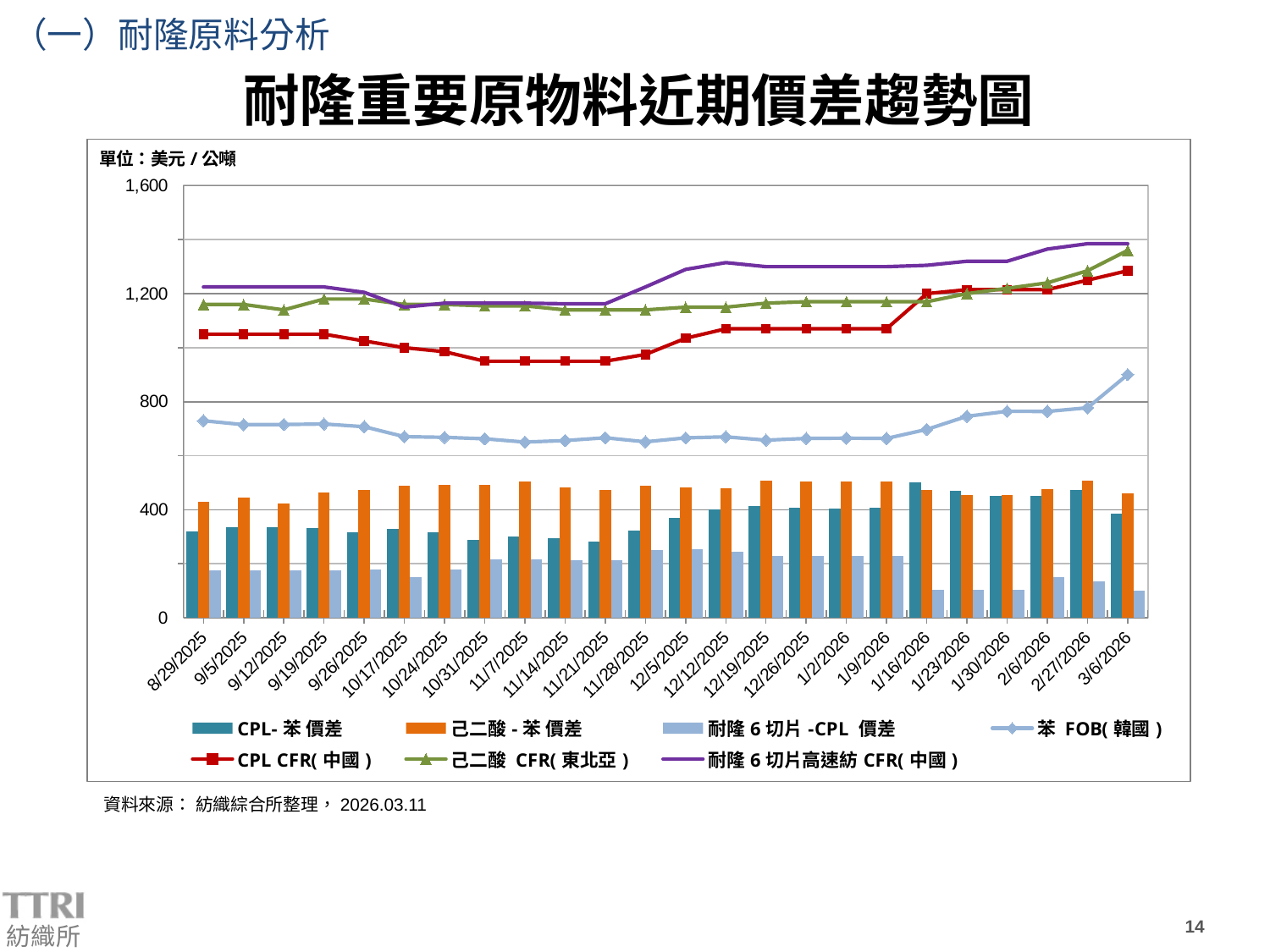
What is the title of the chart? 耐隆重要原物料近期價差趨勢圖 Is the value for CPL CFR(中國) on 10/31/2025 greater or less than 1,200? less How many series does the legend list? 7 How many dates are shown along the x axis? 24 What kind of chart is shown on the slide? A combined bar and line chart On 3/6/2026, which is larger: CPL-苯 價差 or 己二酸-苯 價差? 己二酸-苯 價差 Does 苯 FOB(韓國) rise or fall from 1/9/2026 to 3/6/2026? rise Which series has the highest values across the whole period? 耐隆6切片高速紡 CFR(中國) What unit is stated for the values in the chart? 美元/公噸 Is the value for 耐隆6切片-CPL 價差 on 1/16/2026 greater or less than 400? less Is the value for 苯 FOB(韓國) on 3/6/2026 greater or less than 800? greater